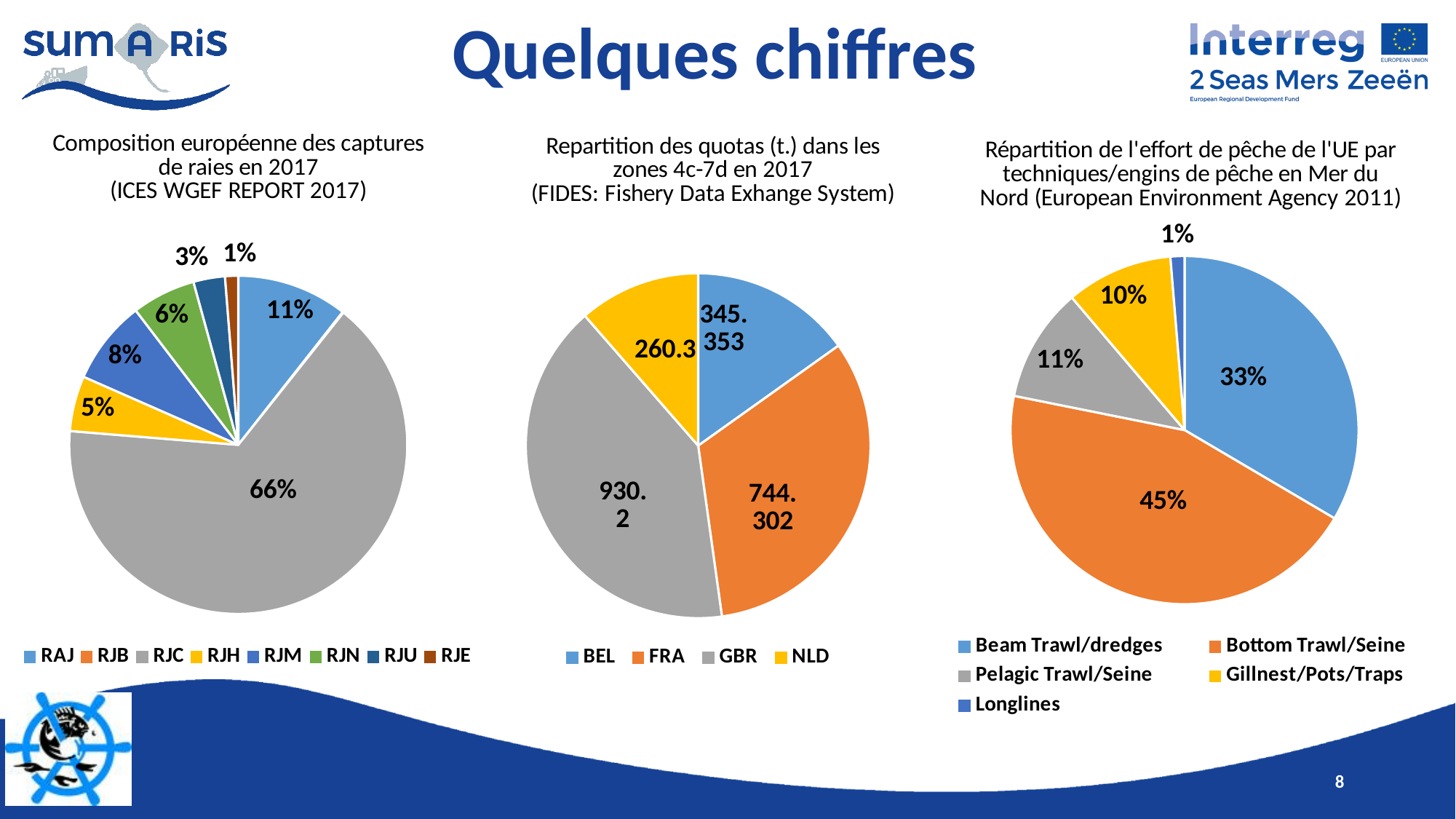
In the middle pie chart (Repartition des quotas dans les zones 4c-7d en 2017), which country has the smallest quota? NLD How many entries does the legend of the left pie chart (Composition européenne des captures de raies en 2017) list? 8 In the middle pie chart (Repartition des quotas dans les zones 4c-7d en 2017), what is the value for FRA? 744.302 In the middle pie chart (Repartition des quotas dans les zones 4c-7d en 2017), what is the difference between the values for GBR and FRA? 185.898 In the left pie chart (Composition européenne des captures de raies en 2017), what is the difference between the shares of RJM and RJH? 3% In the left pie chart (Composition européenne des captures de raies en 2017), what share does RAJ have? 11% In the middle pie chart (Repartition des quotas dans les zones 4c-7d en 2017), what is the value for GBR? 930.2 In the right pie chart (Répartition de l'effort de pêche de l'UE), which is larger: Pelagic Trawl/Seine or Gillnest/Pots/Traps? Pelagic Trawl/Seine In the left pie chart (Composition européenne des captures de raies en 2017), what share does RJC have? 66% In the right pie chart (Répartition de l'effort de pêche de l'UE), what share does Bottom Trawl/Seine have? 45% In the left pie chart (Composition européenne des captures de raies en 2017), which category has the largest slice? RJC What type of chart is the middle chart (Repartition des quotas dans les zones 4c-7d en 2017)? Pie chart